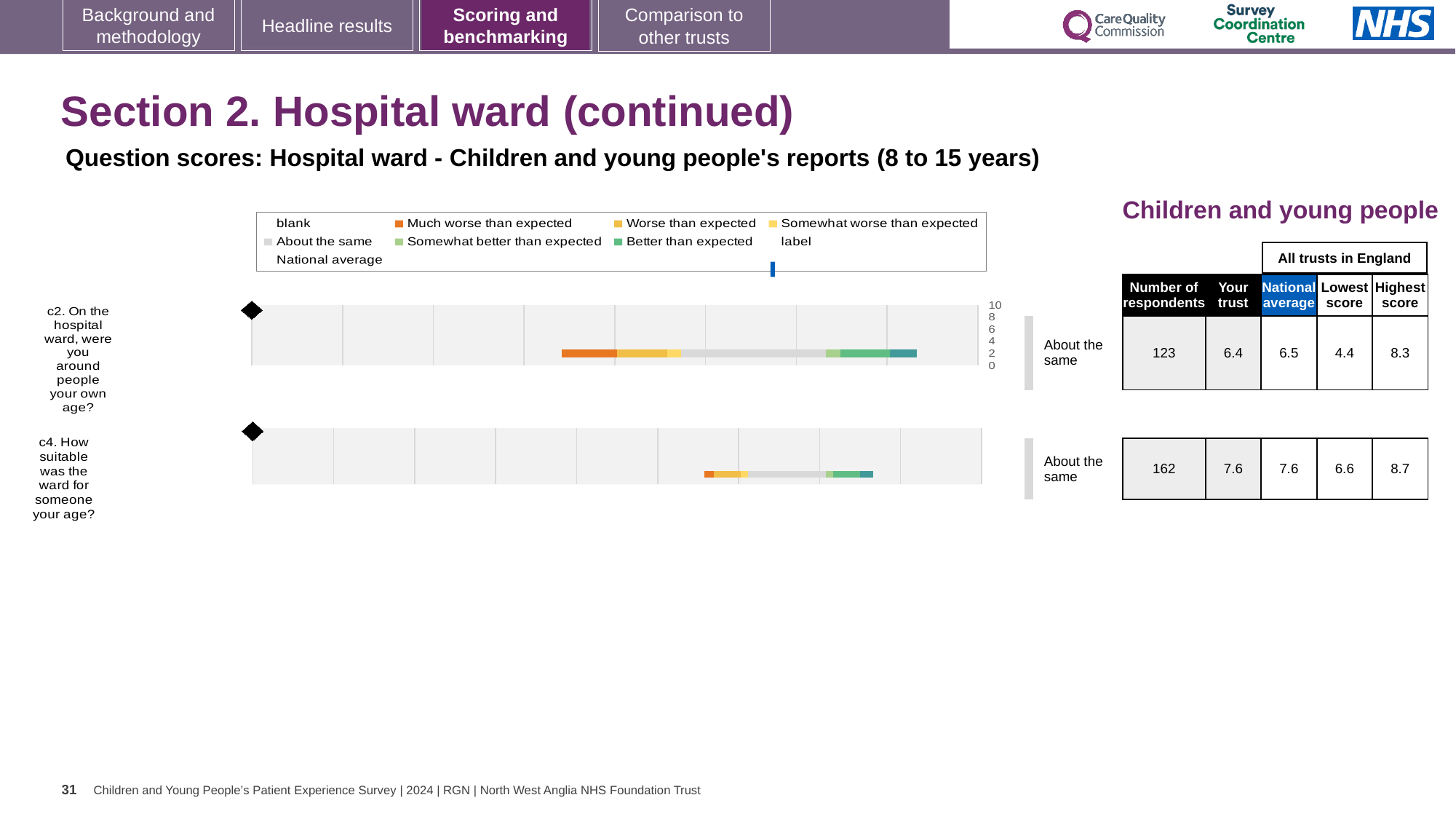
How many respondents answered question c2? 123 What is the difference between the highest and lowest scores across all trusts for question c2? 3.9 For question c2 (On the hospital ward, were you around people your own age?), what is the score for your trust? 6.4 For question c2, which is larger: your trust's score or the national average? National average What is the highest score across all trusts in England for question c4? 8.7 What kind of chart is used to show the question scores for c2 and c4? bar chart What is the lowest score across all trusts in England for question c2? 4.4 How many questions are plotted on the slide? 2 Which question has more respondents, c2 or c4? c4 What is the difference between the highest and lowest scores across all trusts for question c4? 2.1 For question c4 (How suitable was the ward for someone your age?), what is the national average score? 7.6 What benchmark category is shown for question c4? About the same